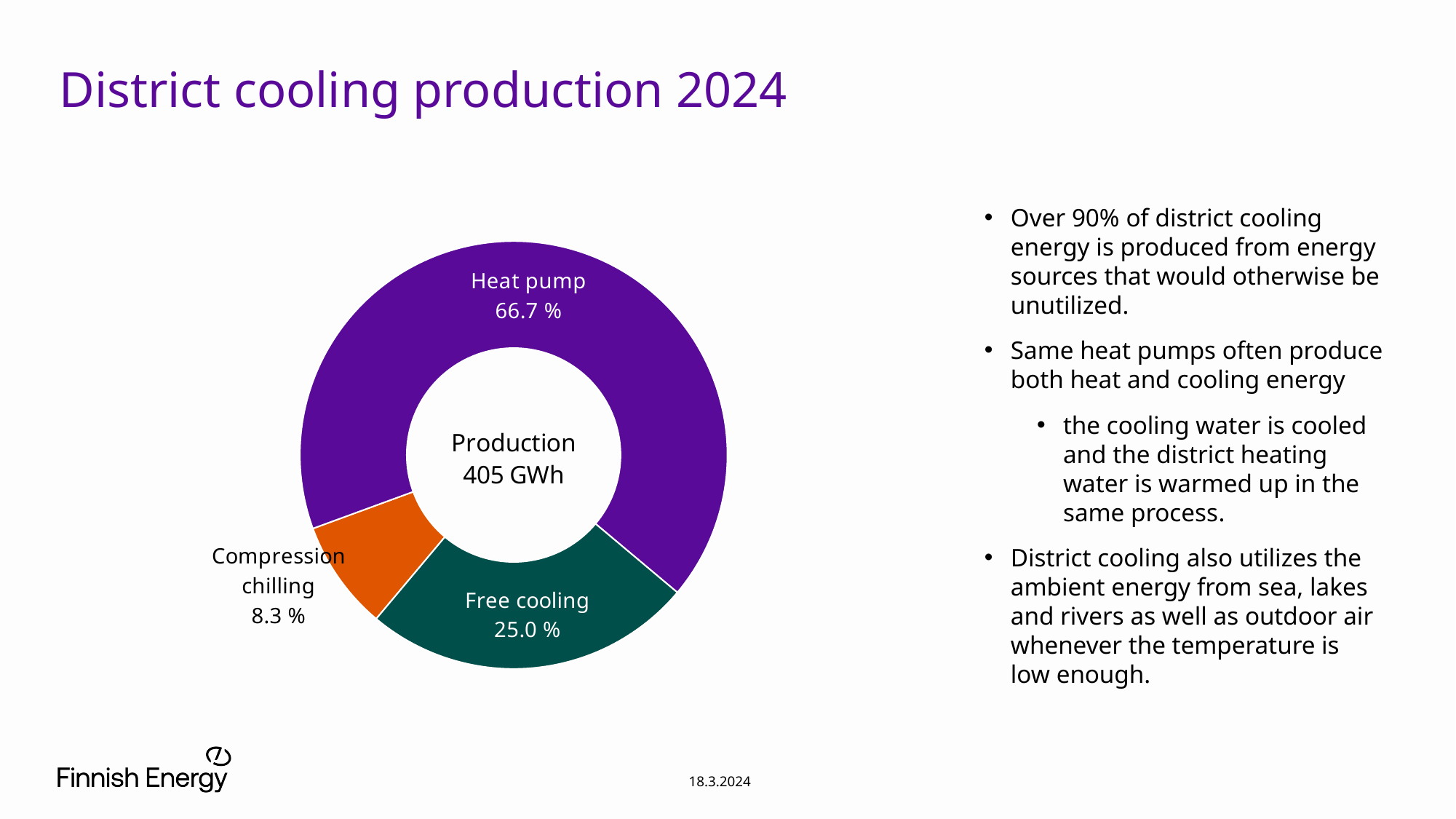
What total production figure is shown in the centre of the chart? 405 GWh What kind of chart is shown on the slide? Doughnut (pie) chart What is the title of the slide containing the chart? District cooling production 2024 What share of district cooling production comes from heat pumps? 66.7 % Which production method has the smallest share of district cooling production? Compression chilling What share of district cooling production comes from free cooling? 25.0 % What is the difference in percentage points between the heat pump share and the free cooling share? 41.7 percentage points What colour is the free cooling segment of the chart? Dark green (teal) Which production method has the largest share of district cooling production? Heat pump How many production methods are shown in the chart? 3 What share of district cooling production comes from compression chilling? 8.3 % Which has a larger share, free cooling or compression chilling? Free cooling